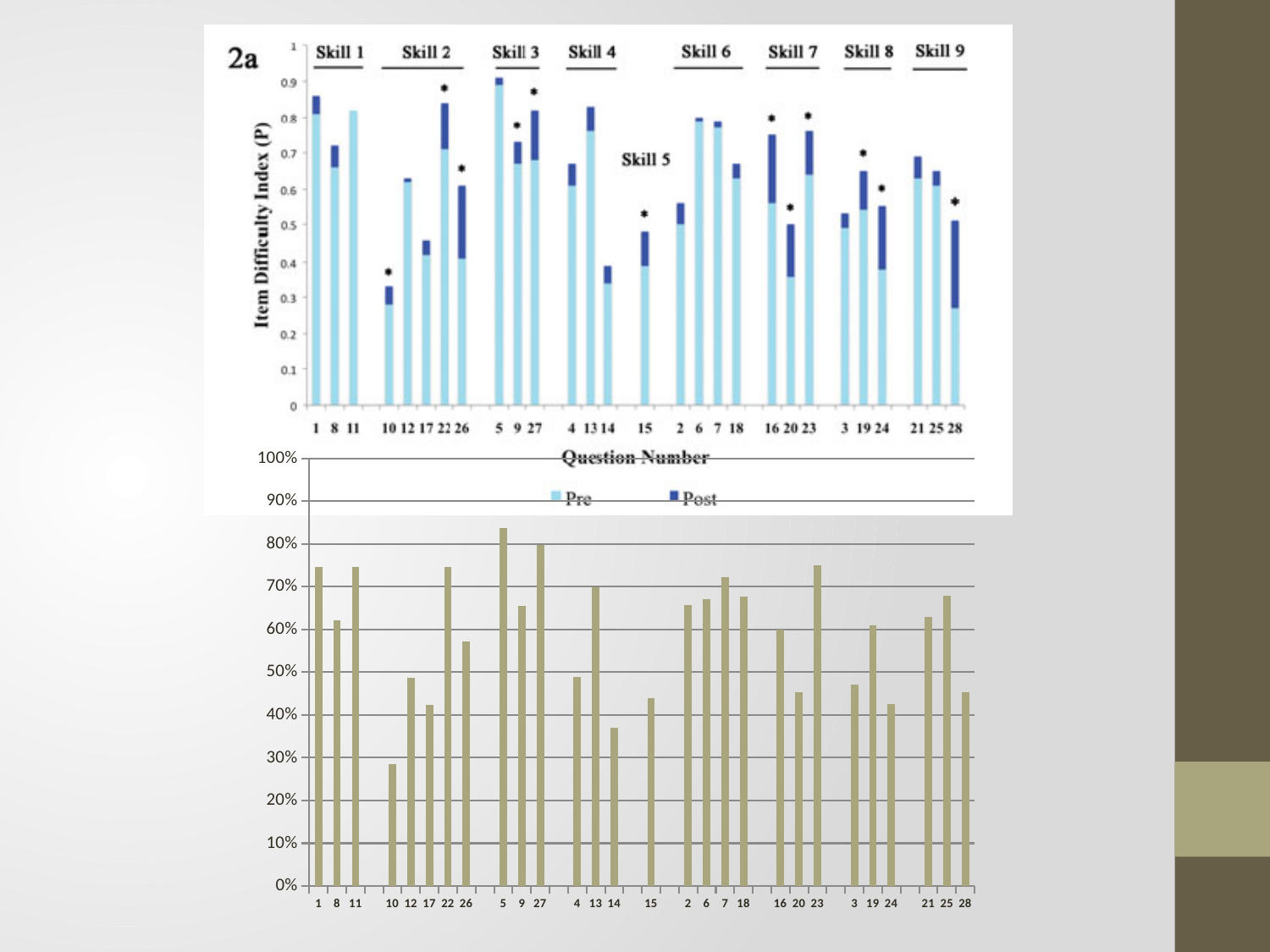
What are the two legend entries in the top chart (2a)? Pre and Post In the top chart (2a), is the Pre value for question 10 greater or less than 0.4? less In the bottom chart, which question number has the highest bar? 5 In the bottom chart, which question number has the lowest bar? 10 In the top chart (2a), is the Pre value for question 1 or question 12 larger? question 1 How many bars are plotted in the bottom chart? 28 How many series does the legend of the top chart (2a) list? 2 What is the y-axis title of the top chart (2a)? Item Difficulty Index (P) In the bottom chart, is the value for question 14 greater or less than 40%? less What kind of chart is the top chart labelled 2a? bar chart In the top chart (2a), is the Pre value for question 5 greater or less than 0.8? greater